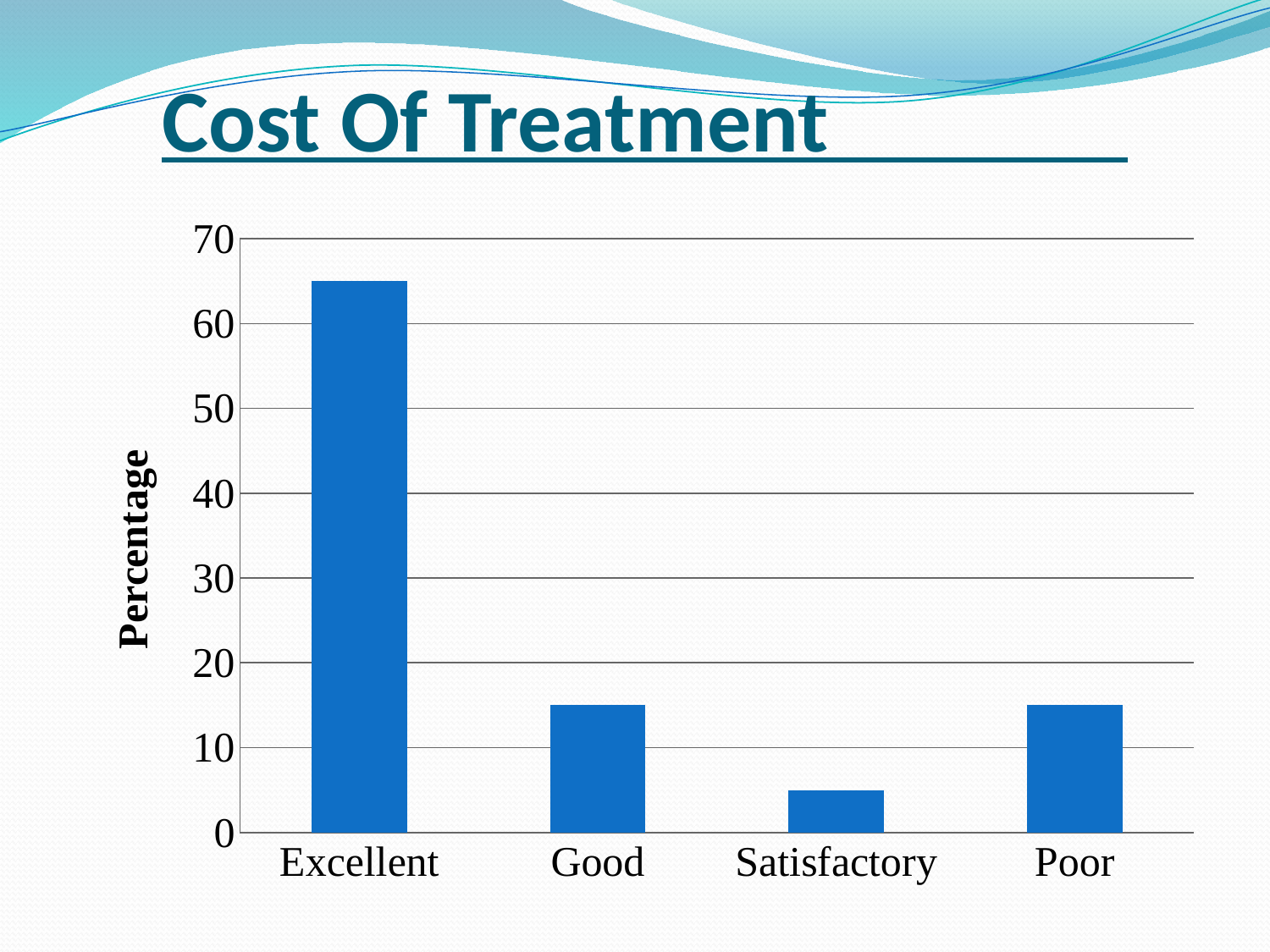
Which category has the lowest percentage? Satisfactory Is the value for Good greater or less than 10? greater Is the value for Poor greater or less than 10? greater What kind of chart is shown on the slide? bar chart Is the value for Good greater or less than 20? less Which is larger, the value for Excellent or the value for Good? Excellent What is the label on the vertical axis? Percentage How many categories are shown on the x axis? 4 Which category has the highest percentage? Excellent